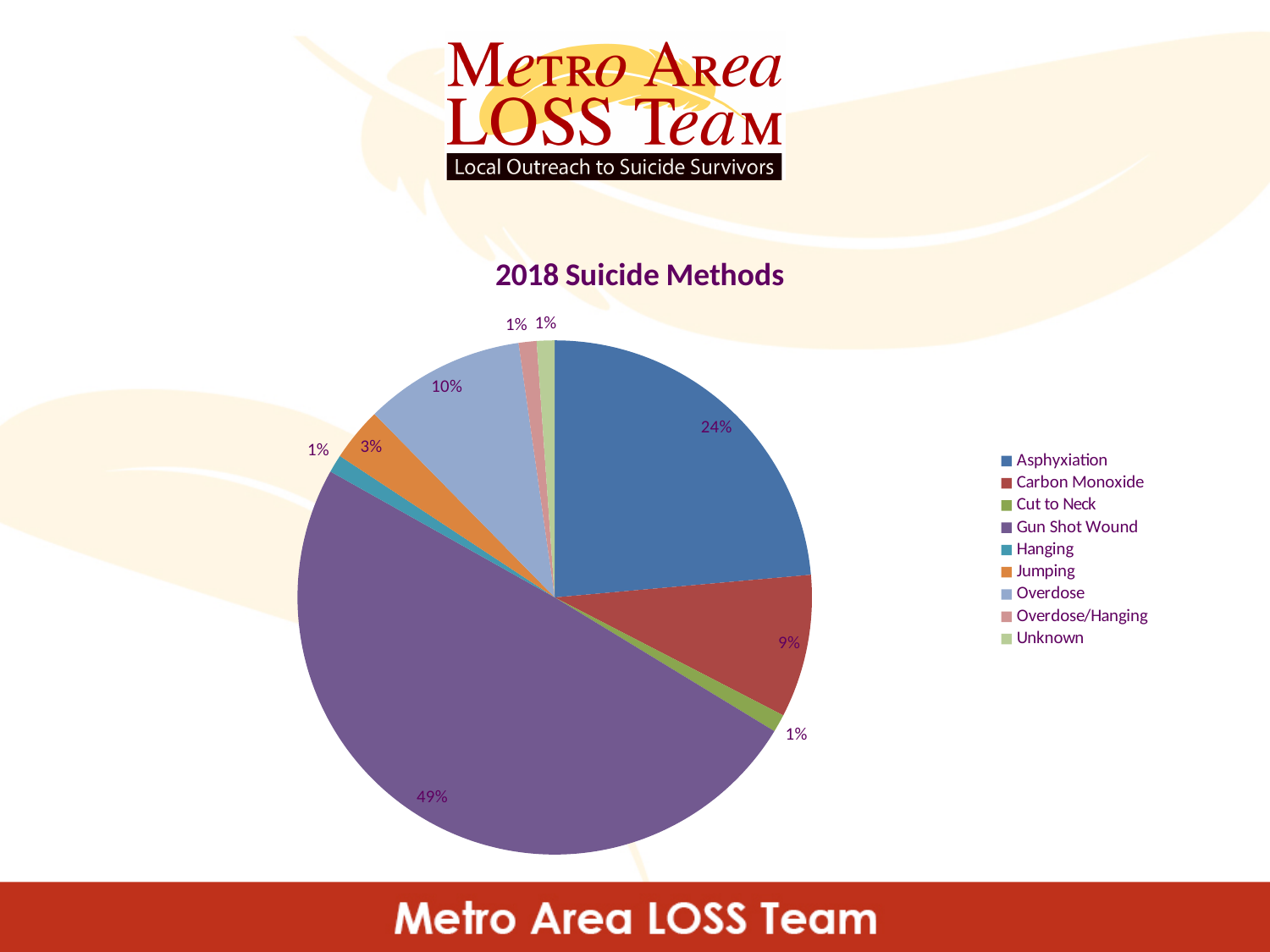
What is the difference in percentage points between Gun Shot Wound and Asphyxiation? 25 What share of the pie does Gun Shot Wound represent? 49% What percentage is shown for Overdose? 10% Which is larger, the share for Overdose or the share for Carbon Monoxide? Overdose What is the combined percentage of Asphyxiation and Carbon Monoxide? 33% What percentage is shown for Carbon Monoxide? 9% How many categories does the legend list? 9 What is the title of the chart? 2018 Suicide Methods What share of the pie does Asphyxiation represent? 24% What type of chart is shown on the slide? pie chart Which suicide method has the largest slice of the pie? Gun Shot Wound What percentage is shown for Jumping? 3%